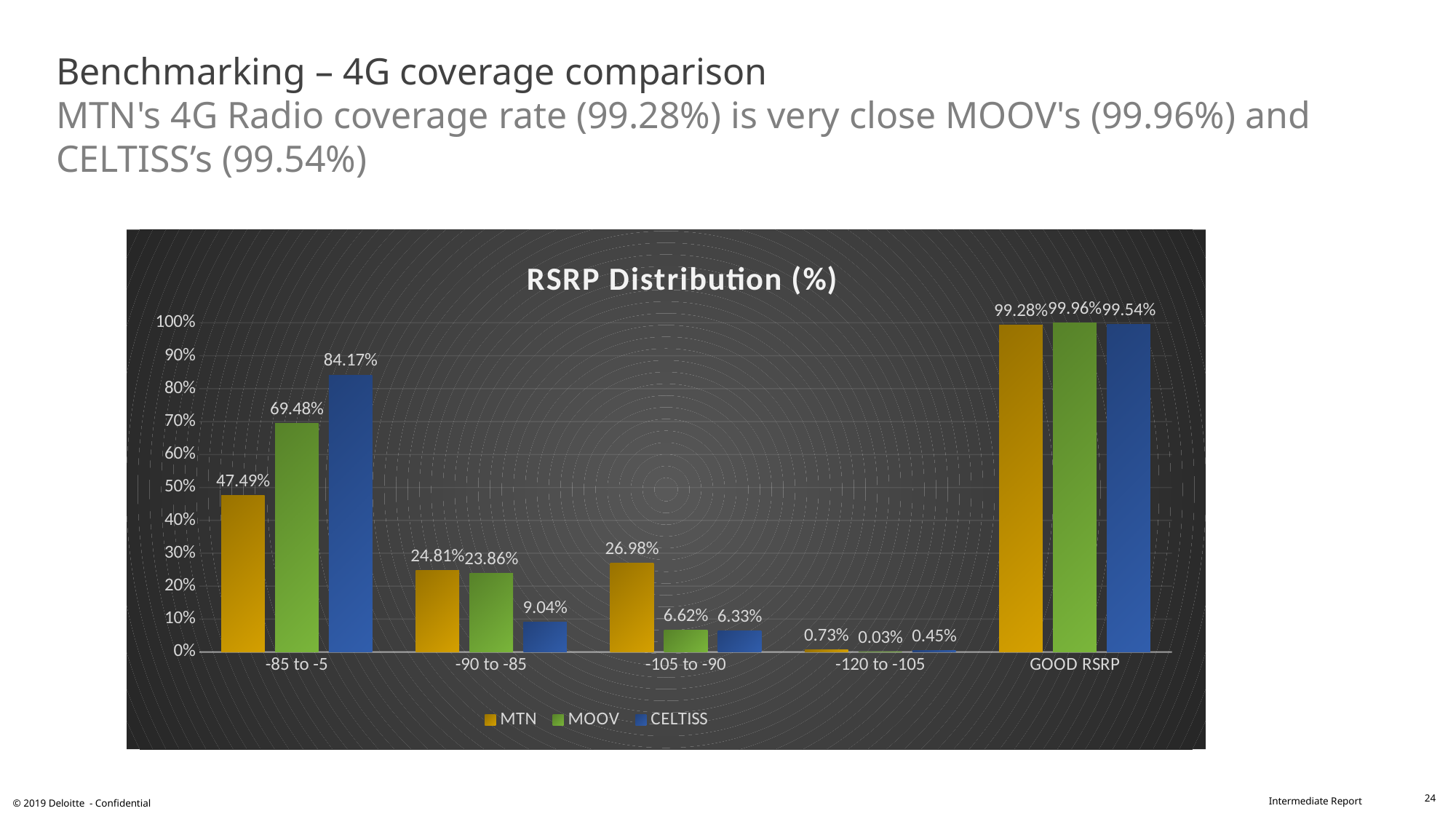
What is the MOOV value for the -120 to -105 category? 0.03% What is the CELTISS value for the -85 to -5 category? 84.17% What type of chart is shown on the slide? Bar chart What is the MTN value for the -85 to -5 category? 47.49% What is the difference between the CELTISS and MTN values in the -85 to -5 category? 36.68% What is the MTN value for the -105 to -90 category? 26.98% Which is larger in the -105 to -90 category, the MOOV value or the CELTISS value? MOOV How many categories are shown on the x axis? 5 What is the MOOV value for the -90 to -85 category? 23.86% Which operator has the lowest value in the GOOD RSRP category? MTN How many series does the legend list? 3 Which operator has the highest value in the -85 to -5 category? CELTISS